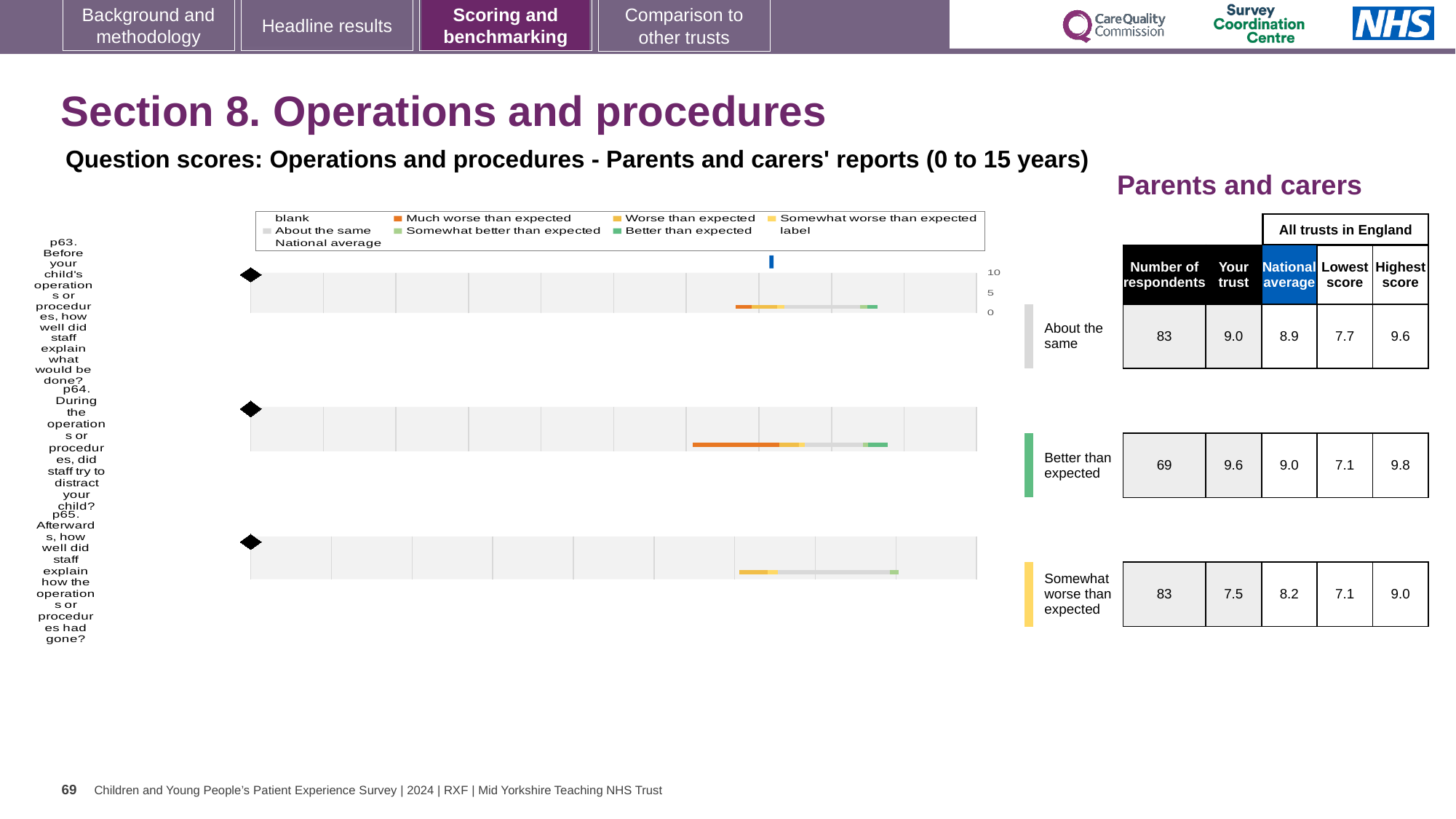
How many questions (bars) are plotted in the chart? 3 What is the 'Your trust' score for p65 (Afterwards, how well did staff explain how the operations or procedures had gone?)? 7.5 Which question has the highest 'Your trust' score? p64 What kind of chart is shown on the slide? bar chart Which question has the lowest 'Your trust' score? p65 How many respondents answered p64? 69 What is the 'Your trust' score for p63 (Before your child's operations or procedures, how well did staff explain what would be done?)? 9.0 What is the national average score for p64 (During the operations or procedures, did staff try to distract your child?)? 9.0 For p65, which is larger: the 'Your trust' score or the national average? National average Which legend entry is shown in dark green? Better than expected What is the difference between the 'Your trust' score and the national average for p64? 0.6 What is the highest value shown on the chart's axis? 10